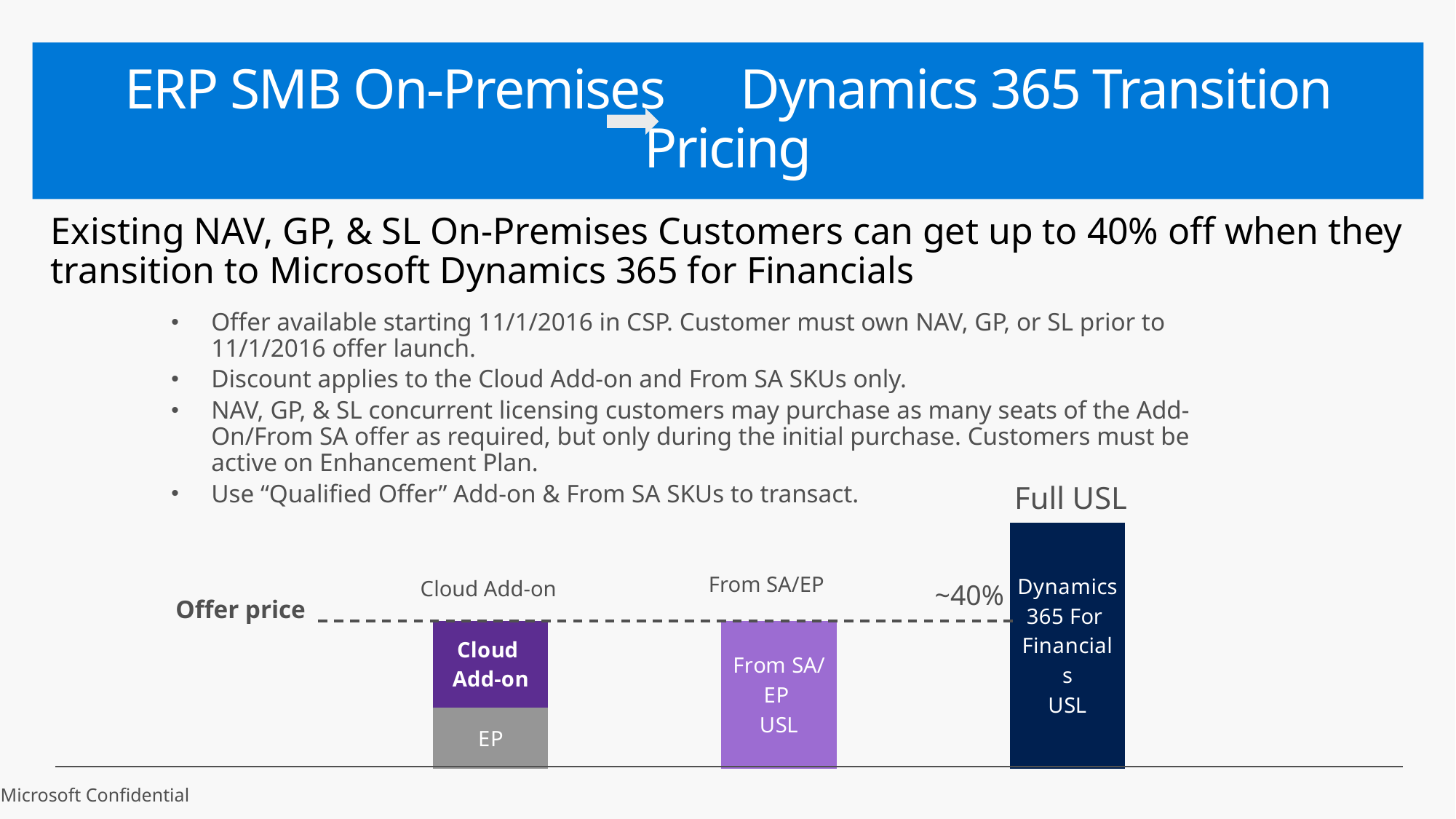
What kind of chart is shown at the bottom of the slide? bar chart How many bars are shown in the chart? 3 How many segments make up the Cloud Add-on bar? 2 What text is written inside the Full USL bar? Dynamics 365 For Financials USL Which is taller in the chart, the Full USL bar or the From SA/EP bar? Full USL Which is taller in the chart, the Full USL bar or the Cloud Add-on bar? Full USL What is the label above the middle bar in the chart? From SA/EP What percentage annotation appears next to the Full USL bar? ~40% What label is given to the dashed horizontal line in the chart? Offer price What are the two segments of the Cloud Add-on bar labelled? Cloud Add-on and EP Which bar in the chart is the tallest? Full USL